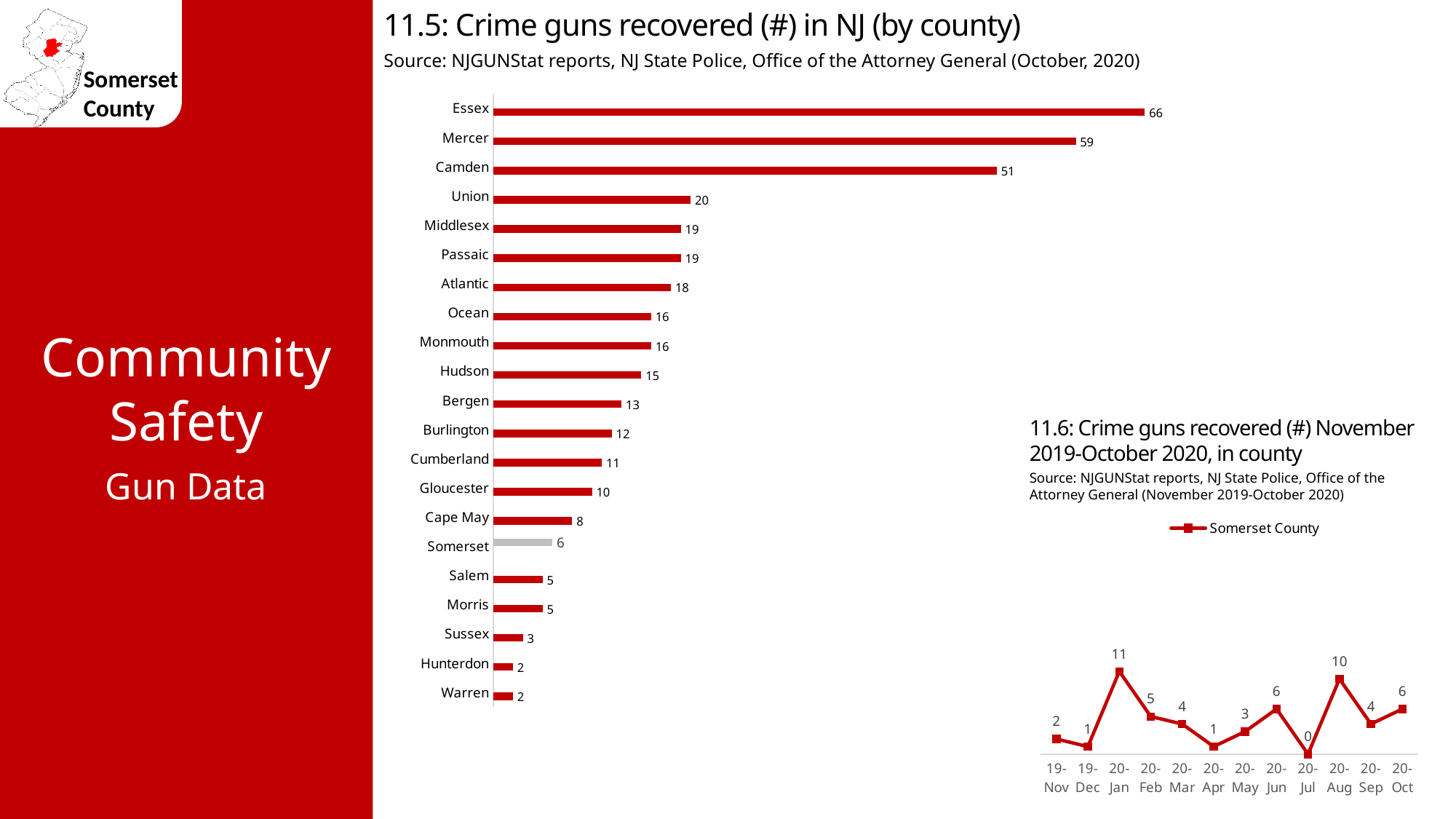
How many series does the legend list in the chart '11.6: Crime guns recovered (#) November 2019-October 2020, in county'? 1 What kind of chart is '11.5: Crime guns recovered (#) in NJ (by county)'? Bar chart In the chart '11.5: Crime guns recovered (#) in NJ (by county)', how many crime guns were recovered in Somerset? 6 In the chart '11.5: Crime guns recovered (#) in NJ (by county)', which is larger, Union or Hudson? Union In the chart '11.5: Crime guns recovered (#) in NJ (by county)', how many counties are listed? 21 In the chart '11.6: Crime guns recovered (#) November 2019-October 2020, in county', what is the difference between 20-Aug and 20-Sep? 6 In the chart '11.6: Crime guns recovered (#) November 2019-October 2020, in county', which month has the lowest value? 20-Jul In the chart '11.5: Crime guns recovered (#) in NJ (by county)', what is the difference between Essex and Camden? 15 In the chart '11.5: Crime guns recovered (#) in NJ (by county)', what is the value for Mercer? 59 In the chart '11.6: Crime guns recovered (#) November 2019-October 2020, in county', what is the value for 20-Jan? 11 In the chart '11.5: Crime guns recovered (#) in NJ (by county)', which bar is shown in grey rather than red? Somerset In the chart '11.5: Crime guns recovered (#) in NJ (by county)', which county has the highest number of crime guns recovered? Essex